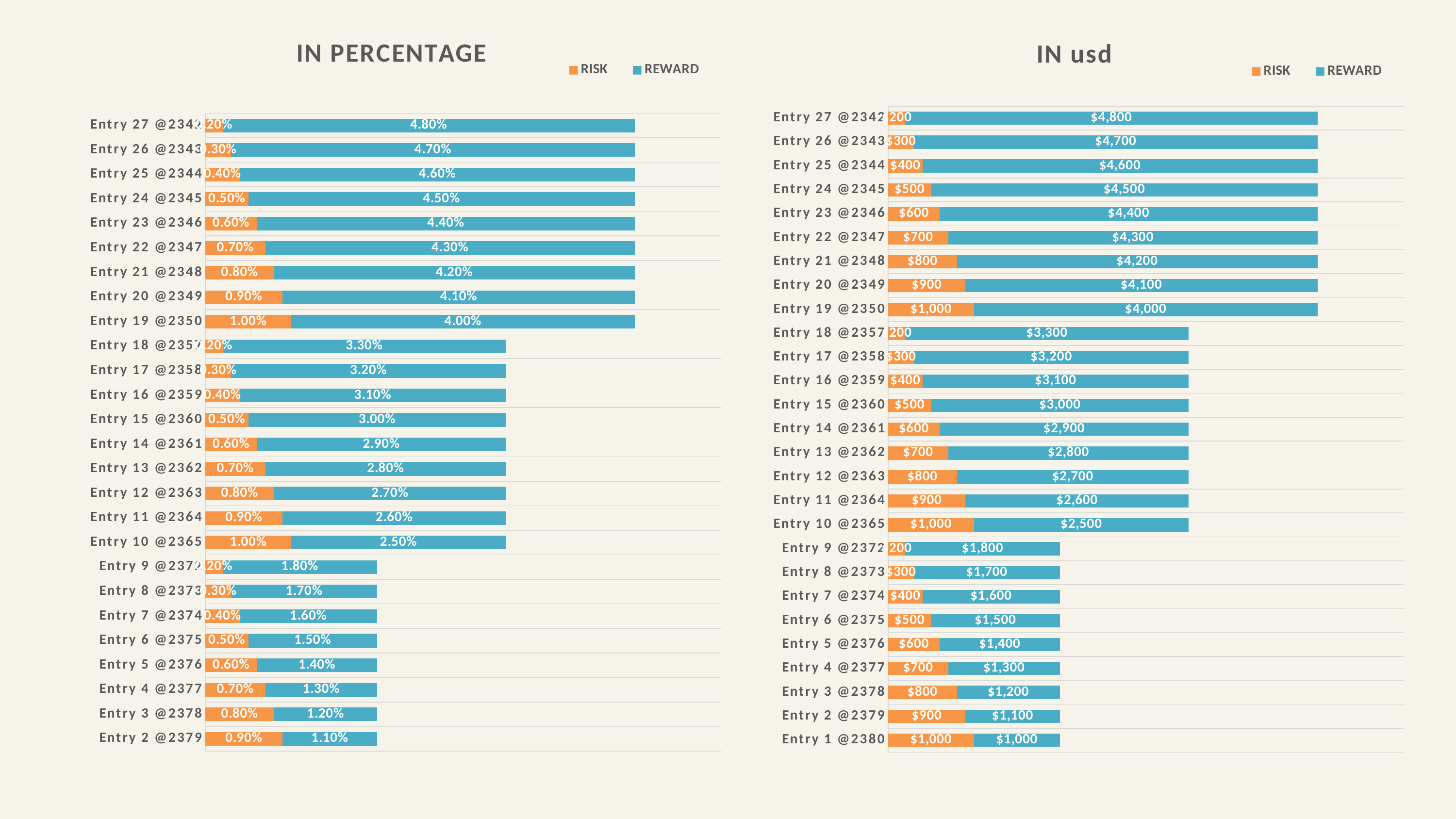
In the IN PERCENTAGE chart, what is the RISK value for Entry 10 @2365? 1.00% In the IN usd chart, which entry has the highest REWARD value? Entry 27 @2342 In the IN PERCENTAGE chart, which entry has the lowest REWARD value? Entry 2 @2379 In the IN PERCENTAGE chart, what is the REWARD value for Entry 19 @2350? 4.00% In the IN usd chart, what is the RISK value for Entry 1 @2380? $1,000 In the IN PERCENTAGE chart, what is the total of the stacked bar for Entry 19 @2350? 5.00% In the IN usd chart, what is the total of the stacked bar for Entry 1 @2380? $2,000 In the IN usd chart, what is the REWARD value for Entry 27 @2342? $4,800 How many series does the legend of the IN usd chart list? 2 In the IN usd chart, which is larger, the REWARD for Entry 9 @2372 or the REWARD for Entry 10 @2365? Entry 10 @2365 In the IN usd chart, what is the difference between the REWARD values for Entry 19 @2350 and Entry 10 @2365? $1,500 What kind of chart is the IN PERCENTAGE chart? Stacked bar chart